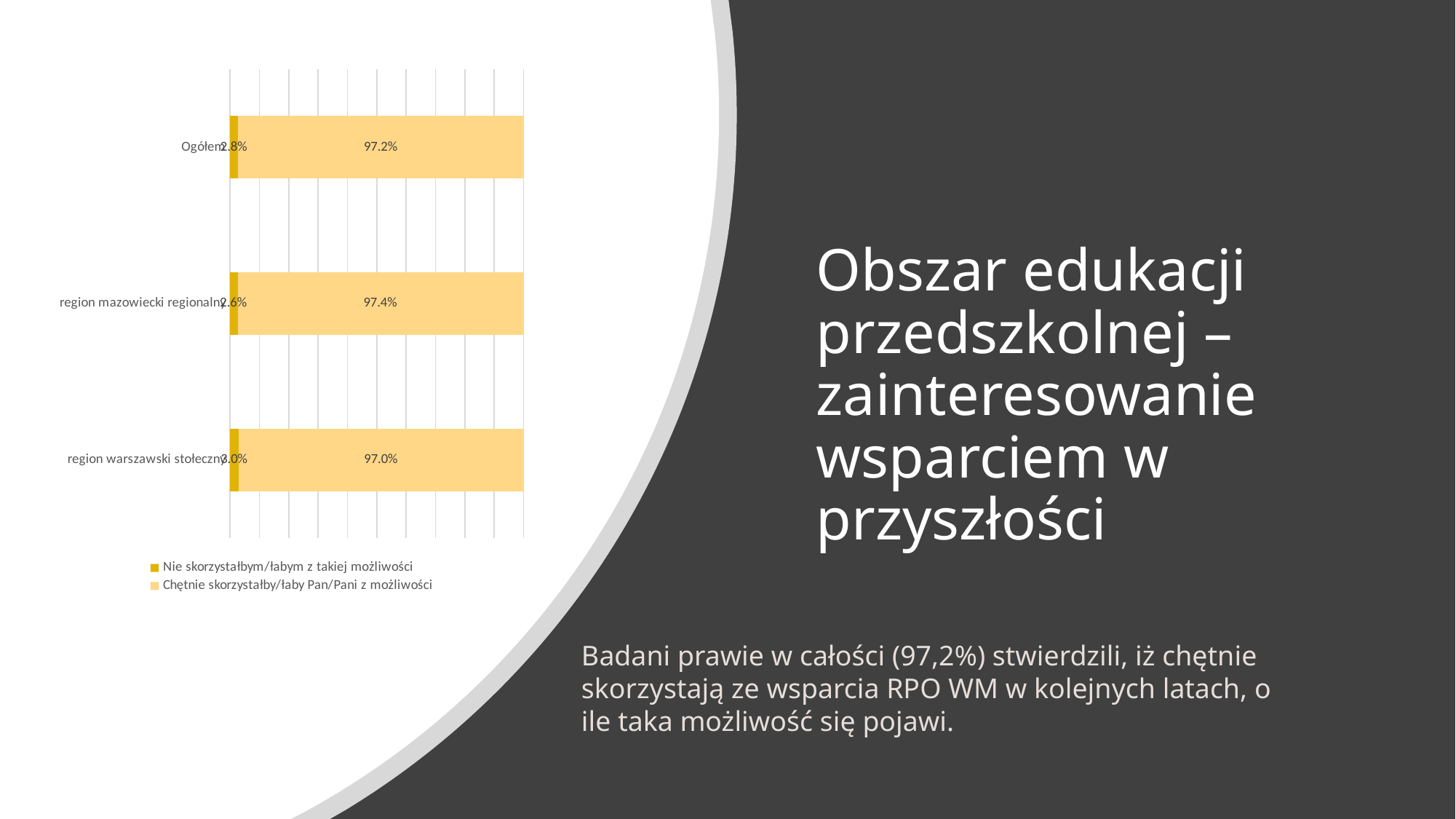
Which category has the highest value for "Chętnie skorzystałby/łaby Pan/Pani z możliwości"? region mazowiecki regionalny What is the value of "Chętnie skorzystałby/łaby Pan/Pani z możliwości" for region mazowiecki regionalny? 97.4% What is the value of "Chętnie skorzystałby/łaby Pan/Pani z możliwości" for region warszawski stołeczny? 97.0% What is the value of "Nie skorzystałbym/łabym z takiej możliwości" for region warszawski stołeczny? 3.0% How many categories are plotted in the chart? 3 What kind of chart is shown on the slide? bar chart Which category has the lowest value for "Chętnie skorzystałby/łaby Pan/Pani z możliwości"? region warszawski stołeczny How many series does the chart legend list? 2 What is the value of "Chętnie skorzystałby/łaby Pan/Pani z możliwości" for Ogółem? 97.2% What is the difference between the "Chętnie skorzystałby/łaby Pan/Pani z możliwości" values for region mazowiecki regionalny and region warszawski stołeczny? 0.4% What is the value of "Nie skorzystałbym/łabym z takiej możliwości" for Ogółem? 2.8% Which series is shown in the lighter yellow colour in the chart? Chętnie skorzystałby/łaby Pan/Pani z możliwości